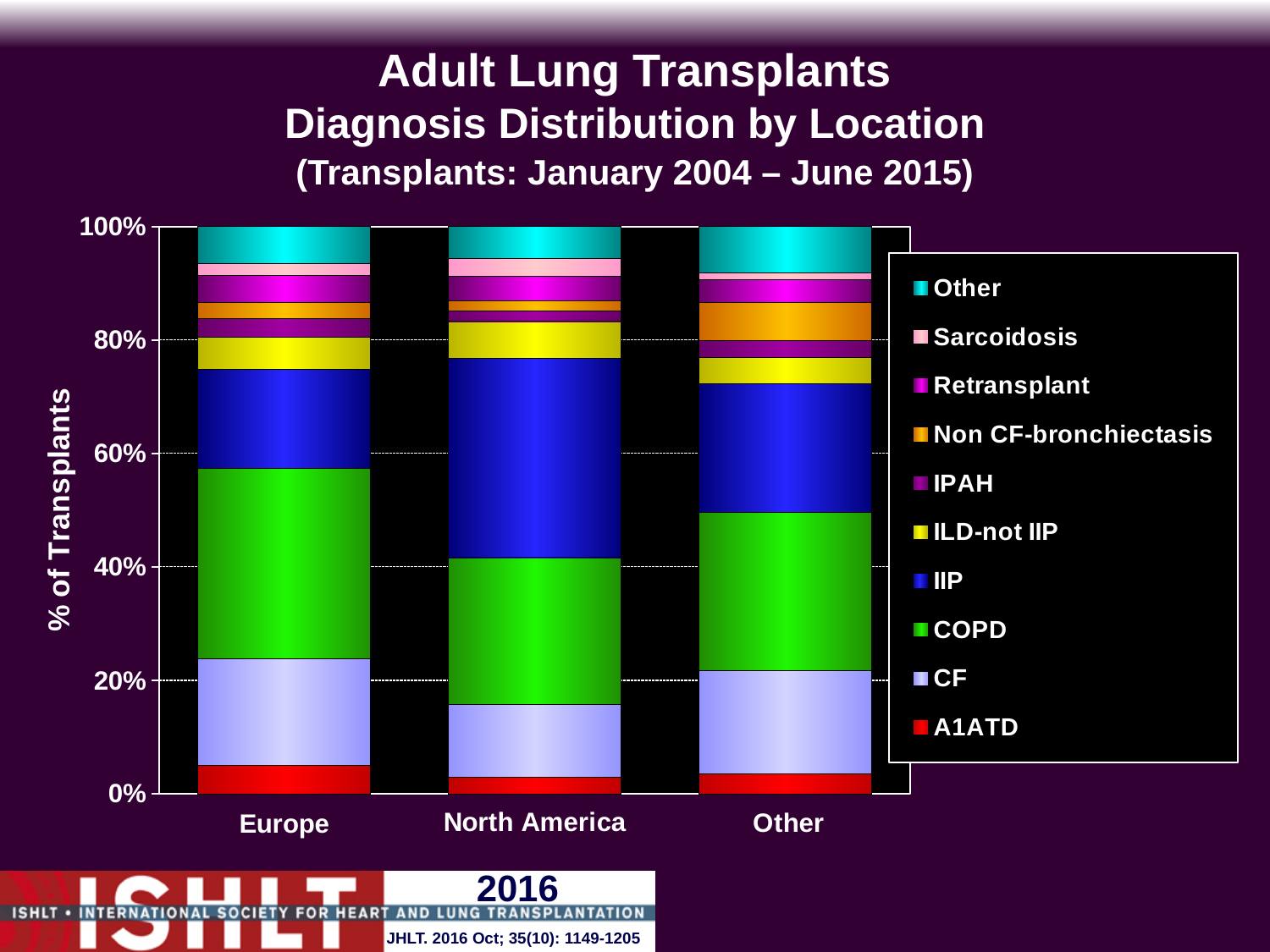
In the North America bar, does the top of the CF segment lie above or below the 20% gridline? below Is the IIP share larger in North America or in Europe? North America Which location has the largest IIP share of transplants? North America How many diagnosis series does the legend list? 10 What is the total height of each stacked bar? 100% How many locations (categories) are shown on the x axis? 3 What kind of chart is shown on the slide? Stacked bar chart In the Europe bar, does the top of the CF segment lie above or below the 20% gridline? above Which location has the largest COPD share of transplants? Europe Is the COPD share larger in Europe or in North America? Europe Which location has the smallest Sarcoidosis share of transplants? Other Which location has the largest Non CF-bronchiectasis share of transplants? Other